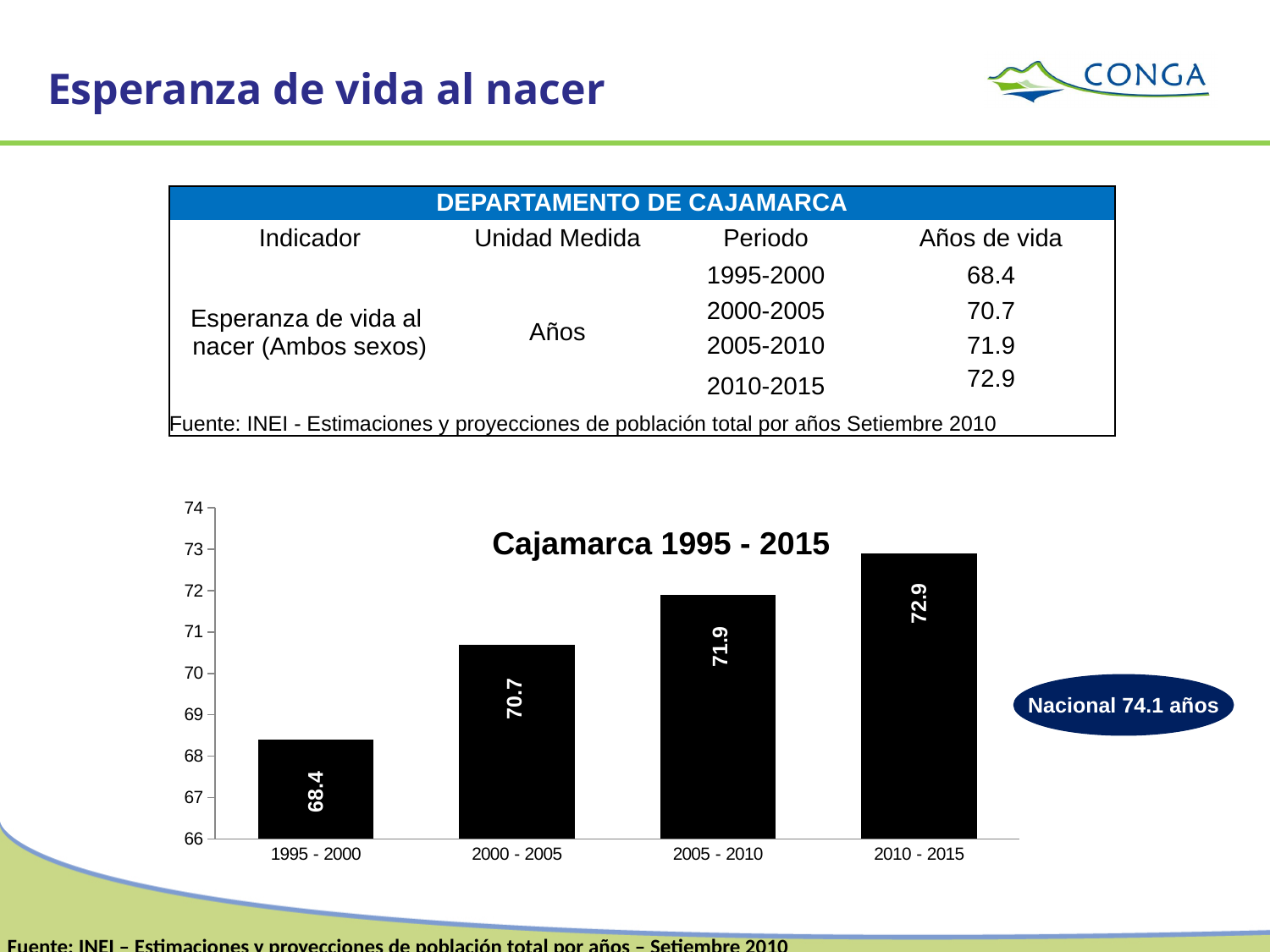
Which is larger, the value for 2005 - 2010 or the value for 2000 - 2005? 2005 - 2010 What is the value for 2010 - 2015 in the chart? 72.9 Which period has the lowest value in the chart? 1995 - 2000 Which period has the highest value in the chart? 2010 - 2015 Is the value for 2000 - 2005 greater or less than 70? greater What is the value for 1995 - 2000 in the chart? 68.4 What is the difference between the values for 2005 - 2010 and 2000 - 2005? 1.2 What kind of chart is shown on the slide? bar chart Do the values rise or fall from 1995 - 2000 to 2010 - 2015? rise What is the value for 2000 - 2005 in the chart? 70.7 What is the difference between the values for 2010 - 2015 and 1995 - 2000? 4.5 How many periods are shown on the x axis of the chart? 4